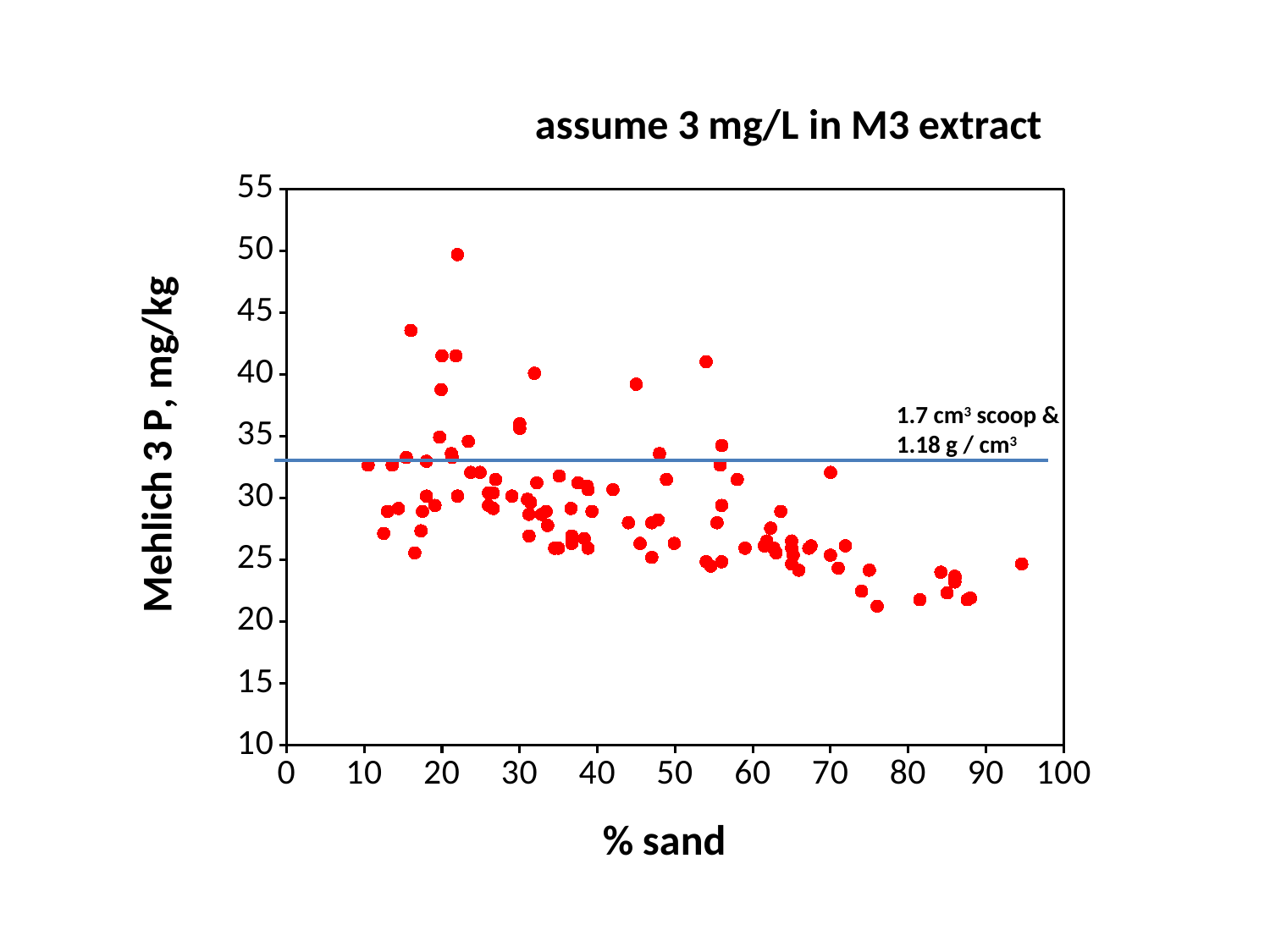
Is the horizontal blue line drawn above or below 35 on the y axis? below Is the lowest plotted point greater or less than 25 mg/kg? less As % sand increases along the x axis, do the Mehlich 3 P values generally rise or fall? Fall What kind of chart is shown on the slide? Scatter plot Is the point plotted at about 54% sand with the highest value in that region greater or less than 40 mg/kg? greater What is the title of the chart? assume 3 mg/L in M3 extract What label is written next to the horizontal blue line on the chart? 1.7 cm³ scoop & 1.18 g / cm³ What is the maximum value shown on the y axis? 55